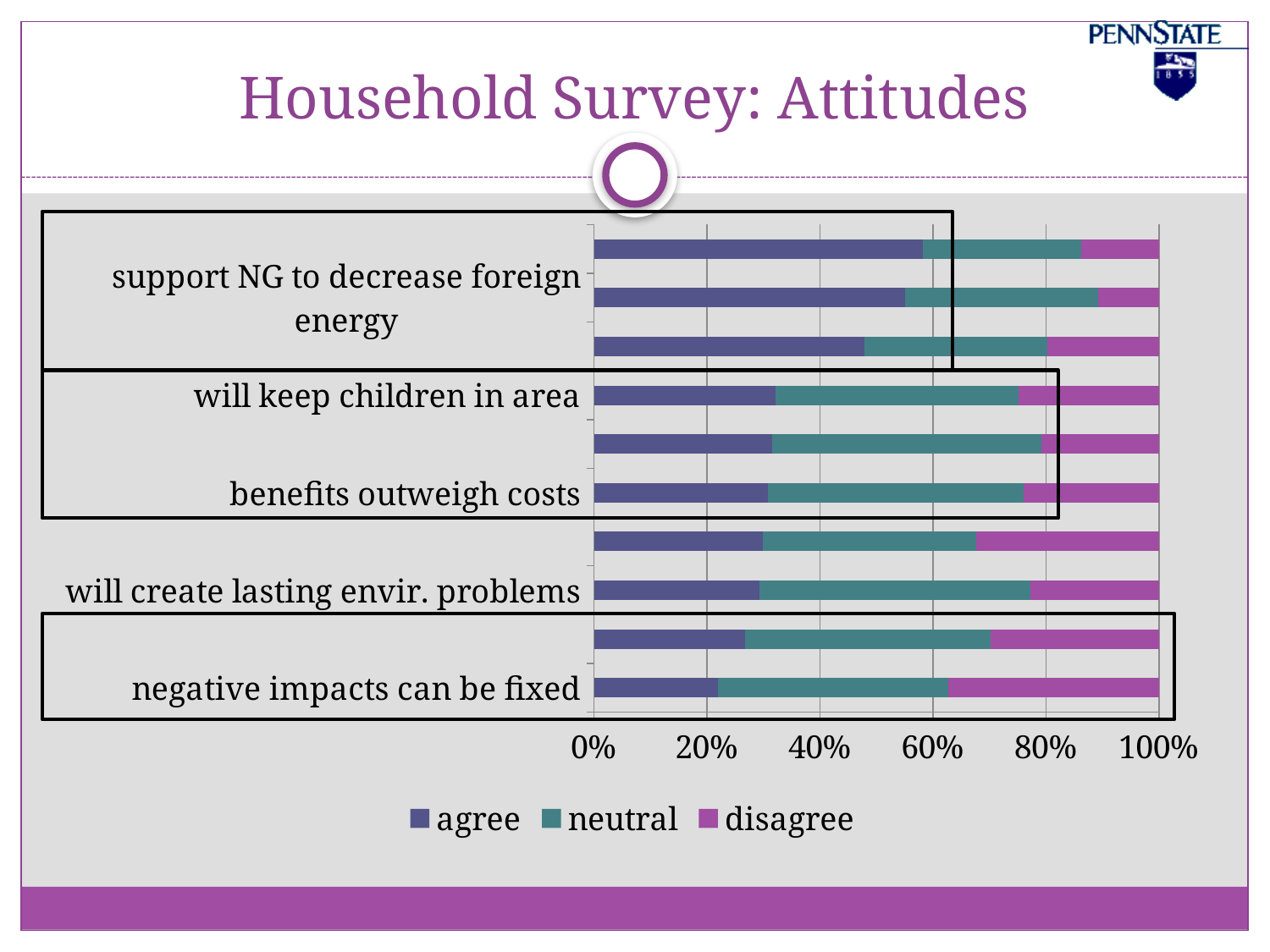
What are the three series named in the legend? agree, neutral, disagree Which has a larger 'disagree' share: 'negative impacts can be fixed' or 'will keep children in area'? negative impacts can be fixed Which has a larger 'agree' share: 'support NG to decrease foreign energy' or 'negative impacts can be fixed'? support NG to decrease foreign energy Is the 'agree' share for 'will keep children in area' greater or less than 40%? less Is the 'agree' share for 'support NG to decrease foreign energy' greater or less than 40%? greater Is the 'agree' share for 'negative impacts can be fixed' greater or less than 40%? less What kind of chart is shown on the slide? stacked bar chart How many series does the legend list? 3 How many bars are plotted in the chart? 10 What is the title of the slide containing the chart? Household Survey: Attitudes